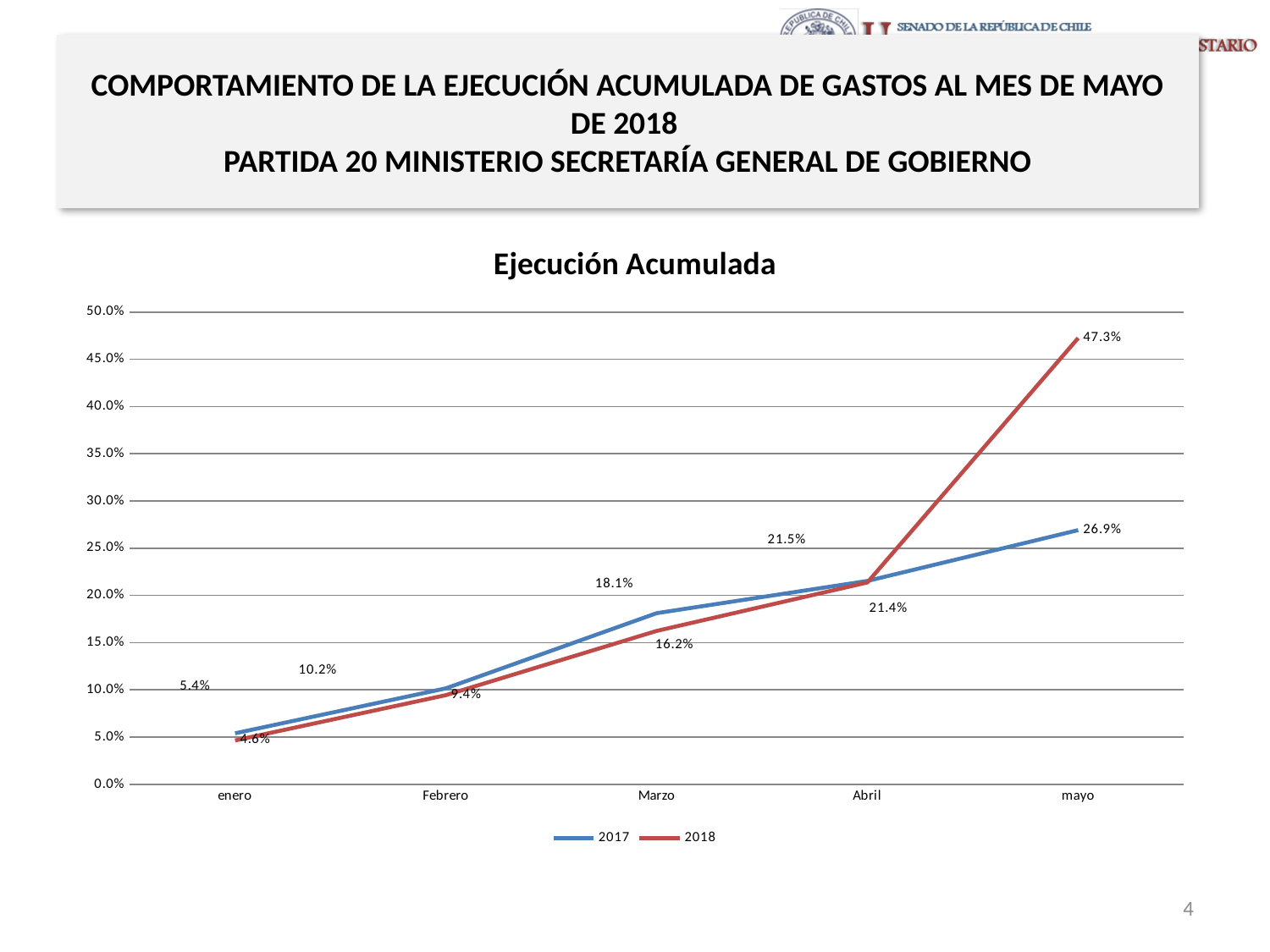
How many months are shown on the x axis? 5 Do the values for 2017 rise or fall from enero to mayo? rise What is the value for 2018 in Abril? 21.4% In which month does the 2018 series reach its highest value? mayo What is the value for 2017 in mayo? 26.9% What is the value for 2017 in Marzo? 18.1% How many series does the legend list? 2 What is the title of the chart? Ejecución Acumulada What type of chart is shown on the slide? line chart What is the difference between the 2018 and 2017 values in mayo? 20.4% Which series has the higher value in Marzo, 2017 or 2018? 2017 What is the value for 2018 in mayo? 47.3%